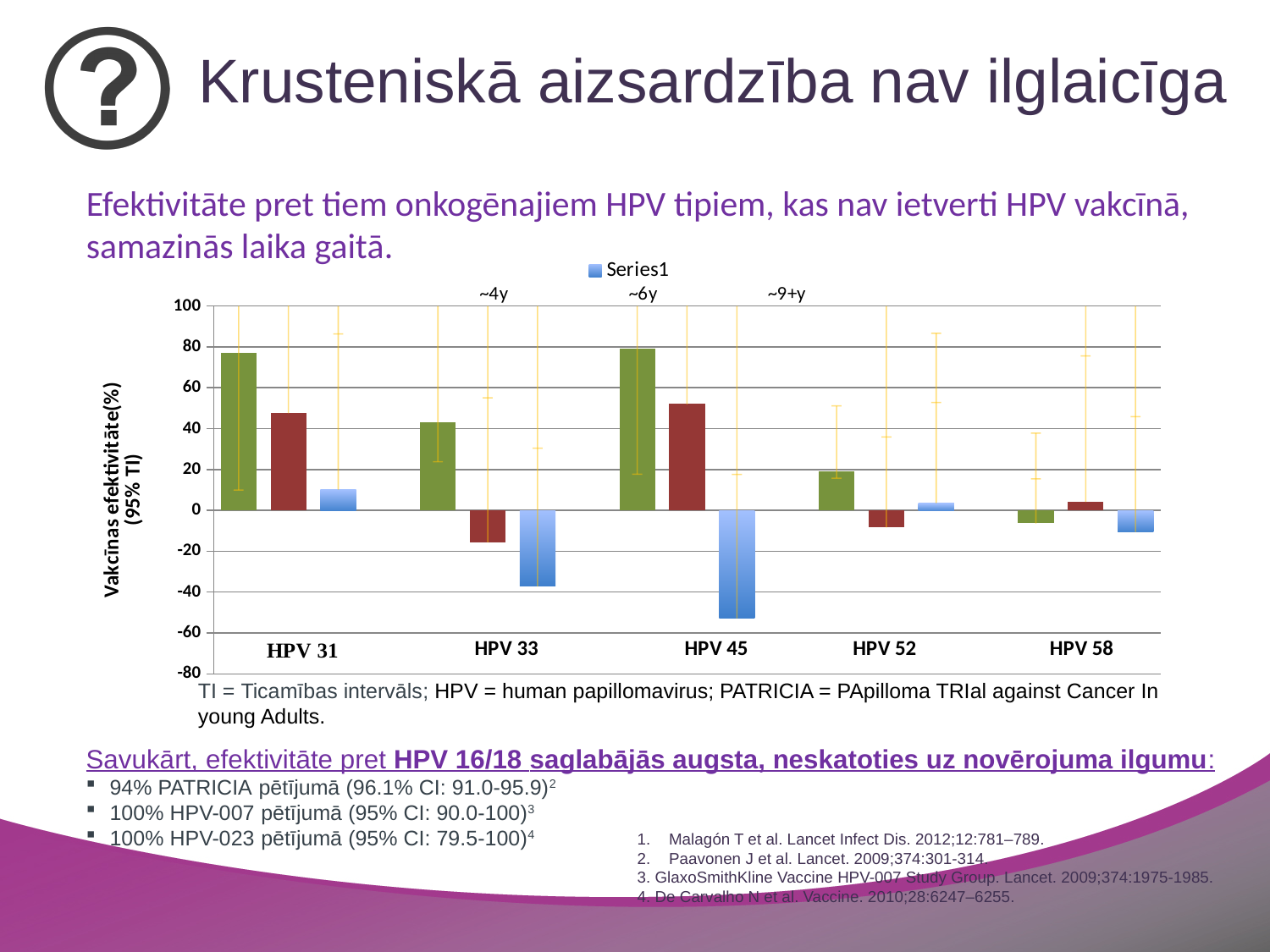
Is the value of the ~6y (red) bar for HPV 33 greater or less than 0? less What is the name of the series shown in the chart legend? Series1 How many HPV type categories are shown on the x axis of the chart? 5 For HPV 31, do the bars rise or fall from ~4y to ~9+y? fall Which HPV type has the lowest ~9+y (blue) bar in the chart? HPV 45 Is the value of the ~9+y (blue) bar for HPV 45 greater or less than -40? less What kind of chart is shown on the slide? bar chart Is the value of the ~4y (green) bar for HPV 52 greater or less than 40? less Which is larger: the ~6y (red) bar for HPV 31 or the ~6y (red) bar for HPV 52? HPV 31 What is the title of the vertical axis of the chart? Vakcīnas efektivitāte(%) (95% TI) How many series does the chart legend list? 1